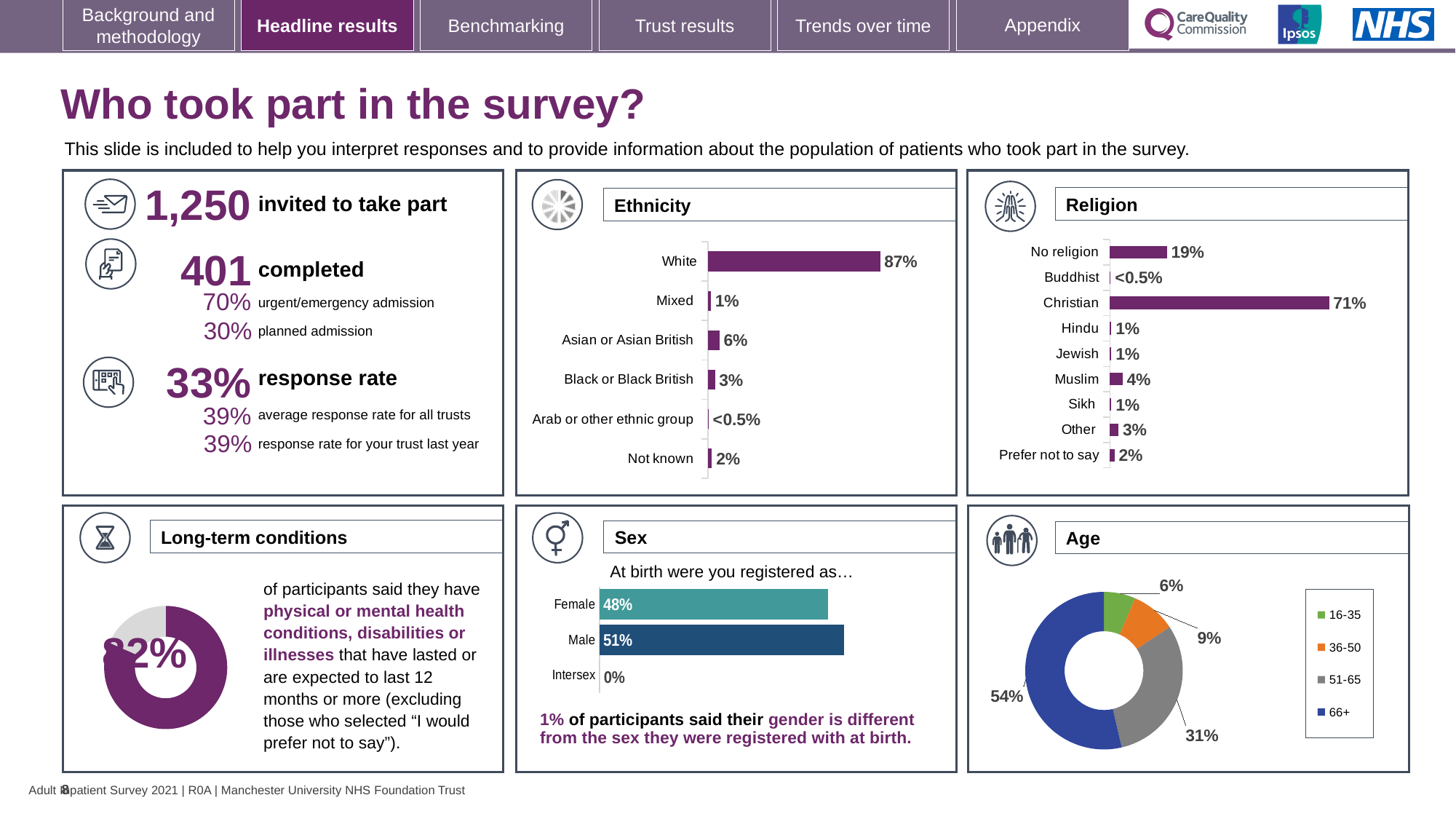
In the Age chart, what share of participants were aged 66+? 54% In the Ethnicity chart, which ethnic group has the lowest percentage? Arab or other ethnic group In the Sex chart, what percentage of participants were registered as Male at birth? 51% In the Religion chart, what is the difference between the Christian and No religion percentages? 52% How many age groups does the legend of the Age chart list? 4 How many ethnic groups are listed in the Ethnicity chart? 6 What kind of chart is the Age chart? Donut chart In the Religion chart, what percentage of participants were Christian? 71% In the Ethnicity chart, what percentage of participants were White? 87% In the Ethnicity chart, what is the difference between the Asian or Asian British and Black or Black British percentages? 3% In the Religion chart, which is larger, Muslim or Other? Muslim In the Religion chart, which religion category has the highest percentage? Christian